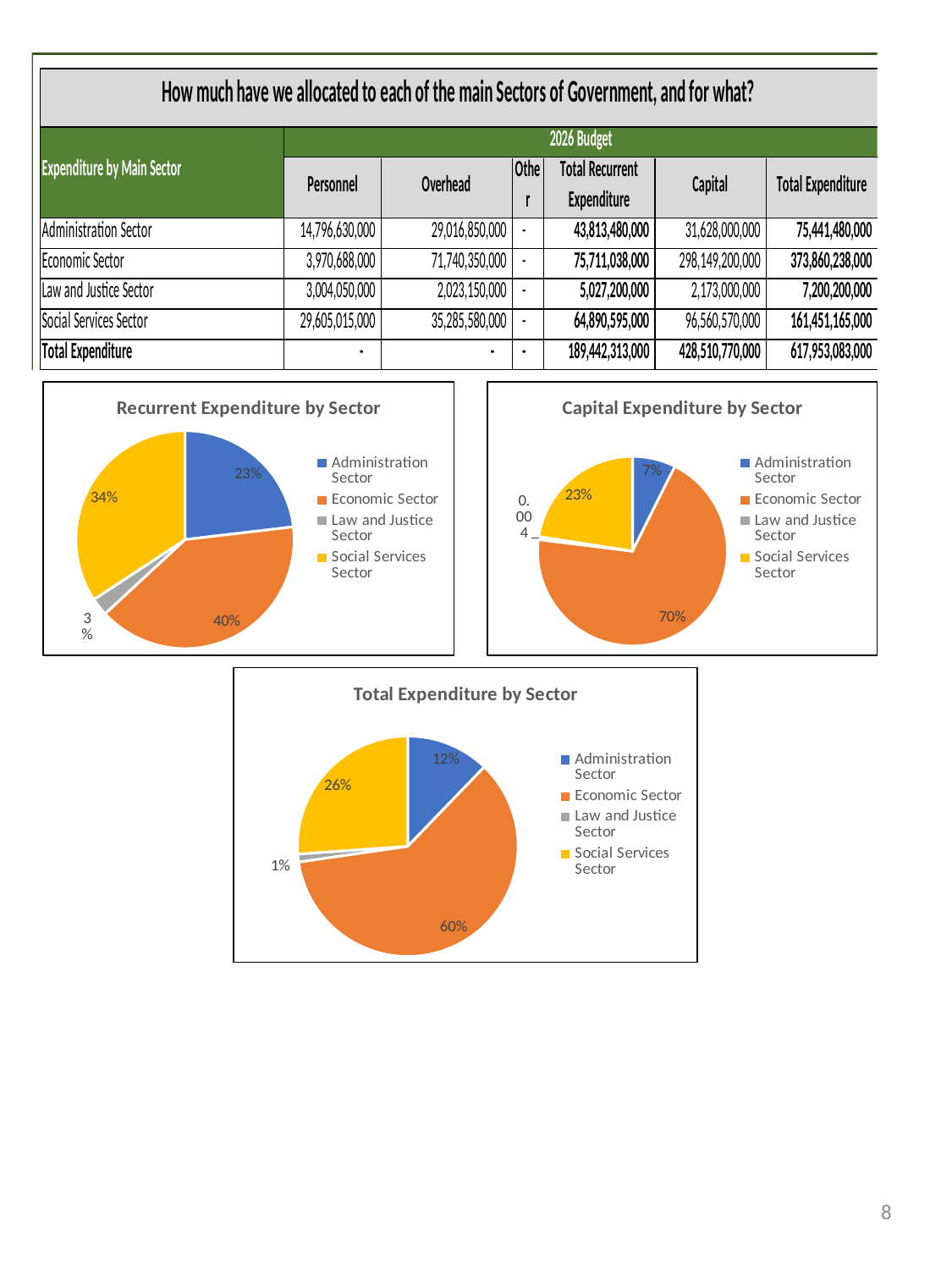
In the Capital Expenditure by Sector chart, which is larger, the Social Services Sector share or the Administration Sector share? Social Services Sector In the Recurrent Expenditure by Sector chart, what share does the Social Services Sector have? 34% In the Capital Expenditure by Sector chart, which sector has the largest slice? Economic Sector How many sectors are listed in the legend of the Total Expenditure by Sector chart? 4 In the Total Expenditure by Sector chart, what share does the Law and Justice Sector have? 1% In the Recurrent Expenditure by Sector chart, what share does the Economic Sector have? 40% In the Recurrent Expenditure by Sector chart, what is the difference between the Economic Sector share and the Administration Sector share? 17% What kind of chart is the Total Expenditure by Sector chart? Pie chart In the Recurrent Expenditure by Sector chart, which sector has the smallest slice? Law and Justice Sector